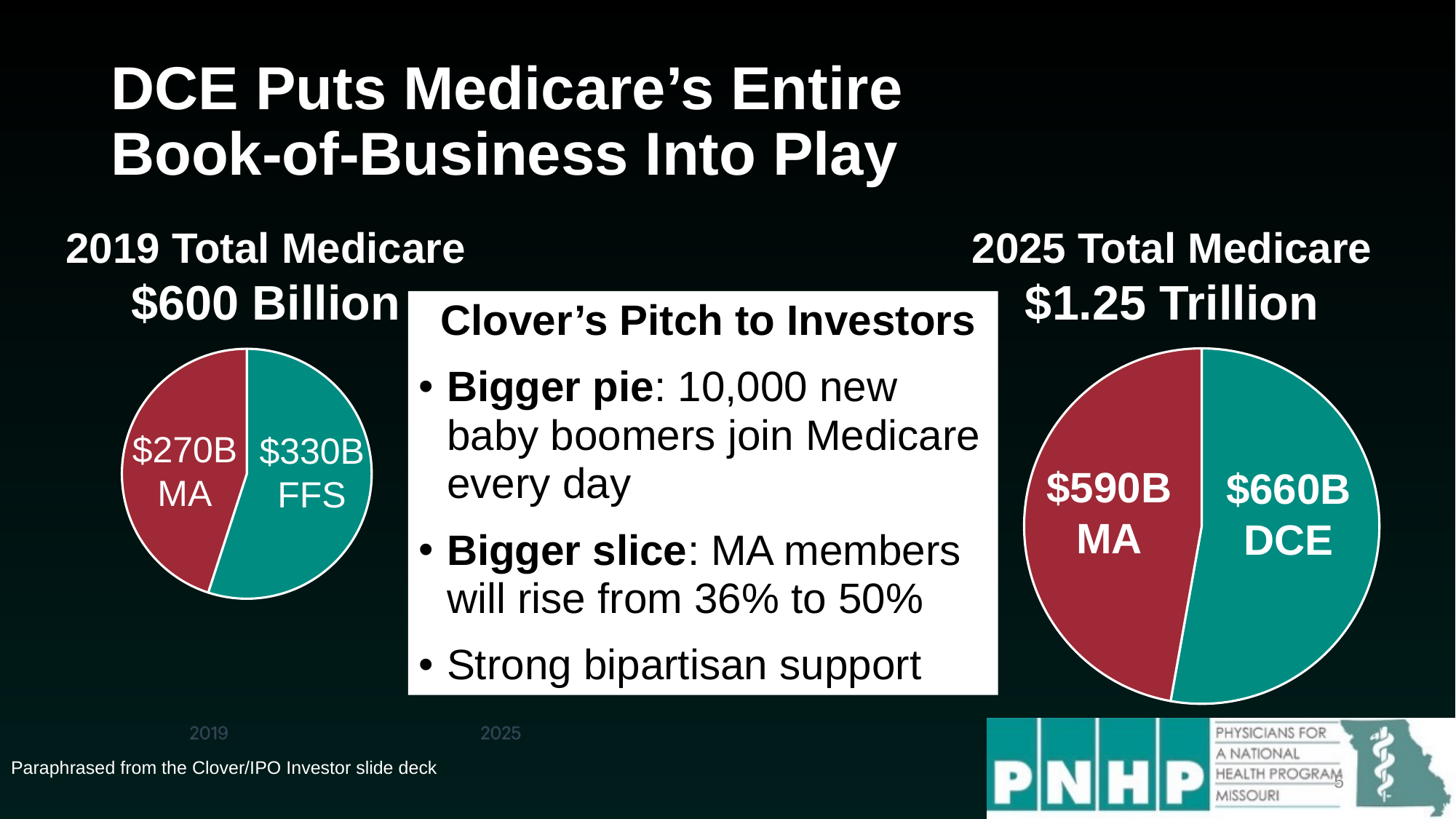
On the 2025 Total Medicare pie chart, what is the difference between the DCE and MA slices? $70B On the 2019 Total Medicare pie chart, what share of the $600 Billion total is the MA slice? 45% What is the total shown for the 2025 Total Medicare pie chart? $1.25 Trillion On the 2025 Total Medicare pie chart, which slice is the largest? DCE On the 2019 Total Medicare pie chart, what is the value of the FFS slice? $330B On the 2019 Total Medicare pie chart, what is the difference between the FFS and MA slices? $60B On the 2019 Total Medicare pie chart, what is the value of the MA slice? $270B On the 2025 Total Medicare pie chart, what is the value of the DCE slice? $660B What kind of chart is used to show 2019 Total Medicare? Pie chart On the 2019 Total Medicare pie chart, which slice is larger, MA or FFS? FFS On the 2025 Total Medicare pie chart, what is the value of the MA slice? $590B How many slices does the 2025 Total Medicare pie chart have? 2